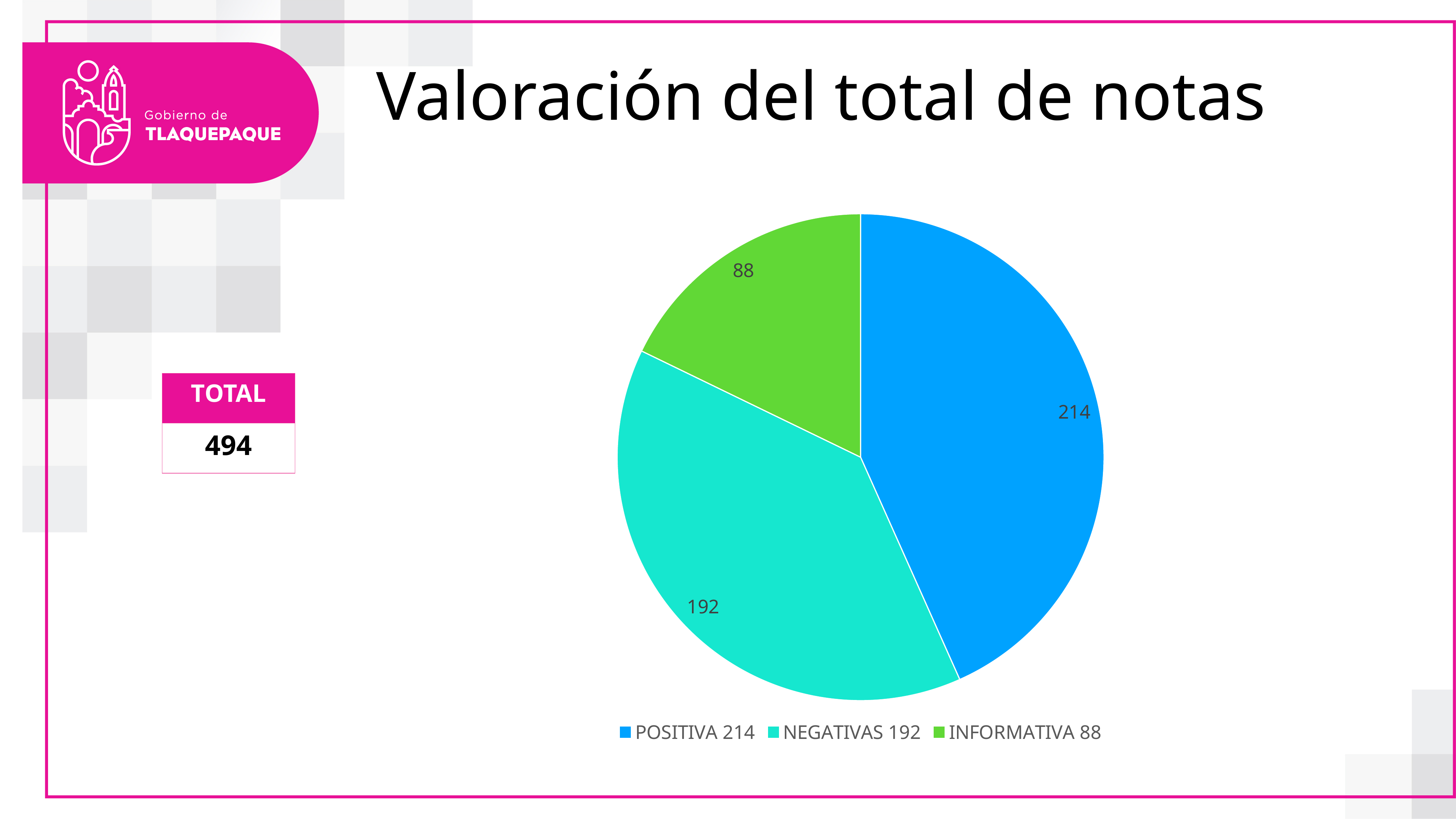
What is the total of all the slices in the pie chart? 494 Which is larger, the value for NEGATIVAS or the value for INFORMATIVA? NEGATIVAS Which category has the largest slice in the pie chart? POSITIVA What is the value for POSITIVA in the pie chart? 214 What is the value for INFORMATIVA in the pie chart? 88 What type of chart is shown on the slide? pie chart What is the difference between the NEGATIVAS and INFORMATIVA values? 104 What is the difference between the POSITIVA and NEGATIVAS values? 22 Which category has the smallest slice in the pie chart? INFORMATIVA What is the value for NEGATIVAS in the pie chart? 192 What is the title of the slide containing the pie chart? Valoración del total de notas How many slices does the pie chart have? 3